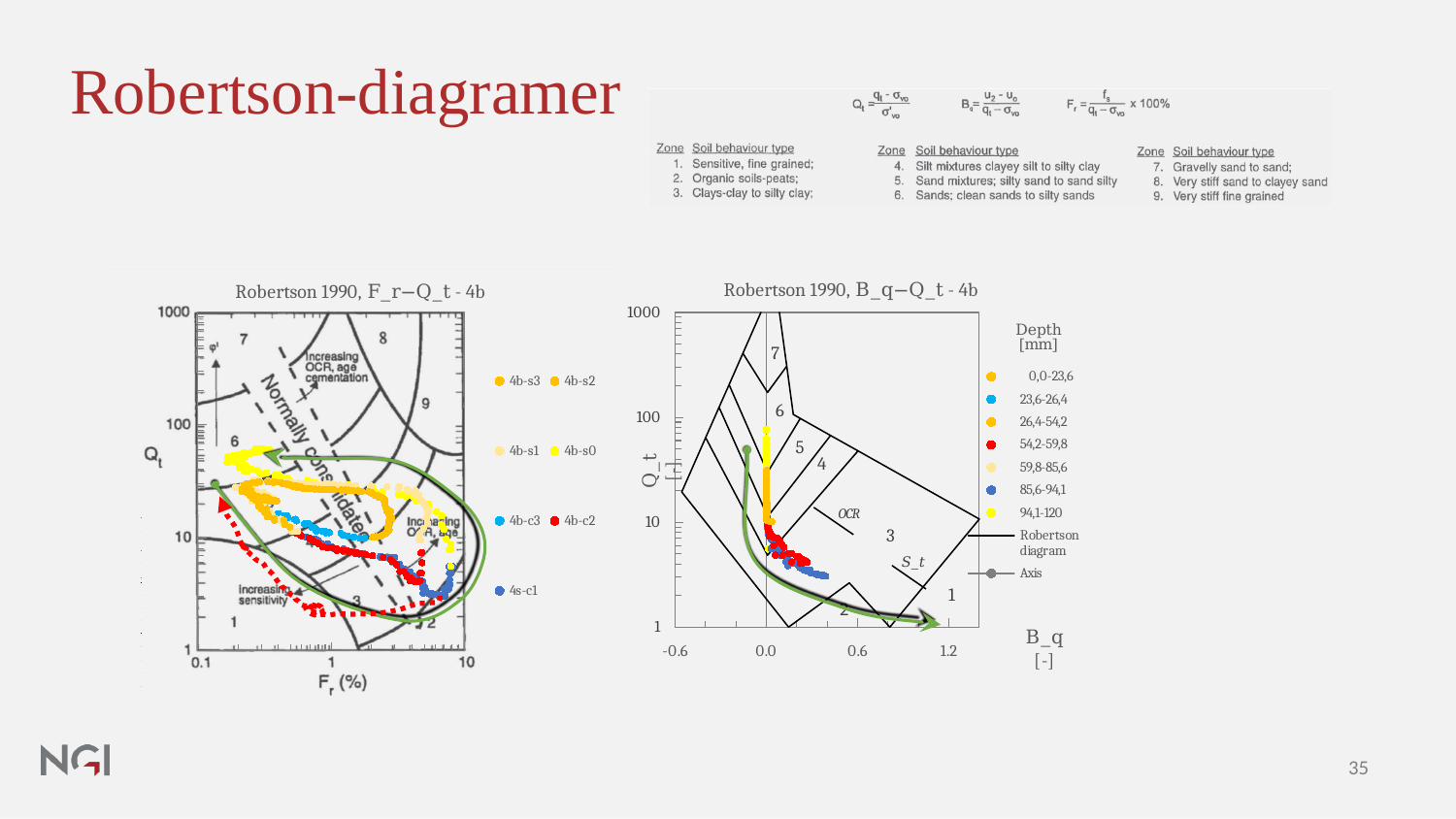
In the right chart "Robertson 1990, B_q–Q_t - 4b", what is the last depth range listed in the legend? 94,1-120 In the left chart "Robertson 1990, F_r–Q_t - 4b", how many series does the legend list? 7 In the left chart "Robertson 1990, F_r–Q_t - 4b", what is the label of the x axis? F_r (%) In the right chart "Robertson 1990, B_q–Q_t - 4b", what is the first depth range listed in the legend? 0,0-23,6 What kind of chart is the right chart titled "Robertson 1990, B_q–Q_t - 4b"? scatter chart In the left chart "Robertson 1990, F_r–Q_t - 4b", are the Q_t values of the 4b-s2 points greater or less than 1? greater In the right chart "Robertson 1990, B_q–Q_t - 4b", what is the label of the x axis? B_q [-] What kind of chart is the left chart titled "Robertson 1990, F_r–Q_t - 4b"? scatter chart In the right chart "Robertson 1990, B_q–Q_t - 4b", how many depth ranges does the legend list? 7 In the right chart "Robertson 1990, B_q–Q_t - 4b", are the Q_t values of the 54,2-59,8 depth points greater or less than 100? less